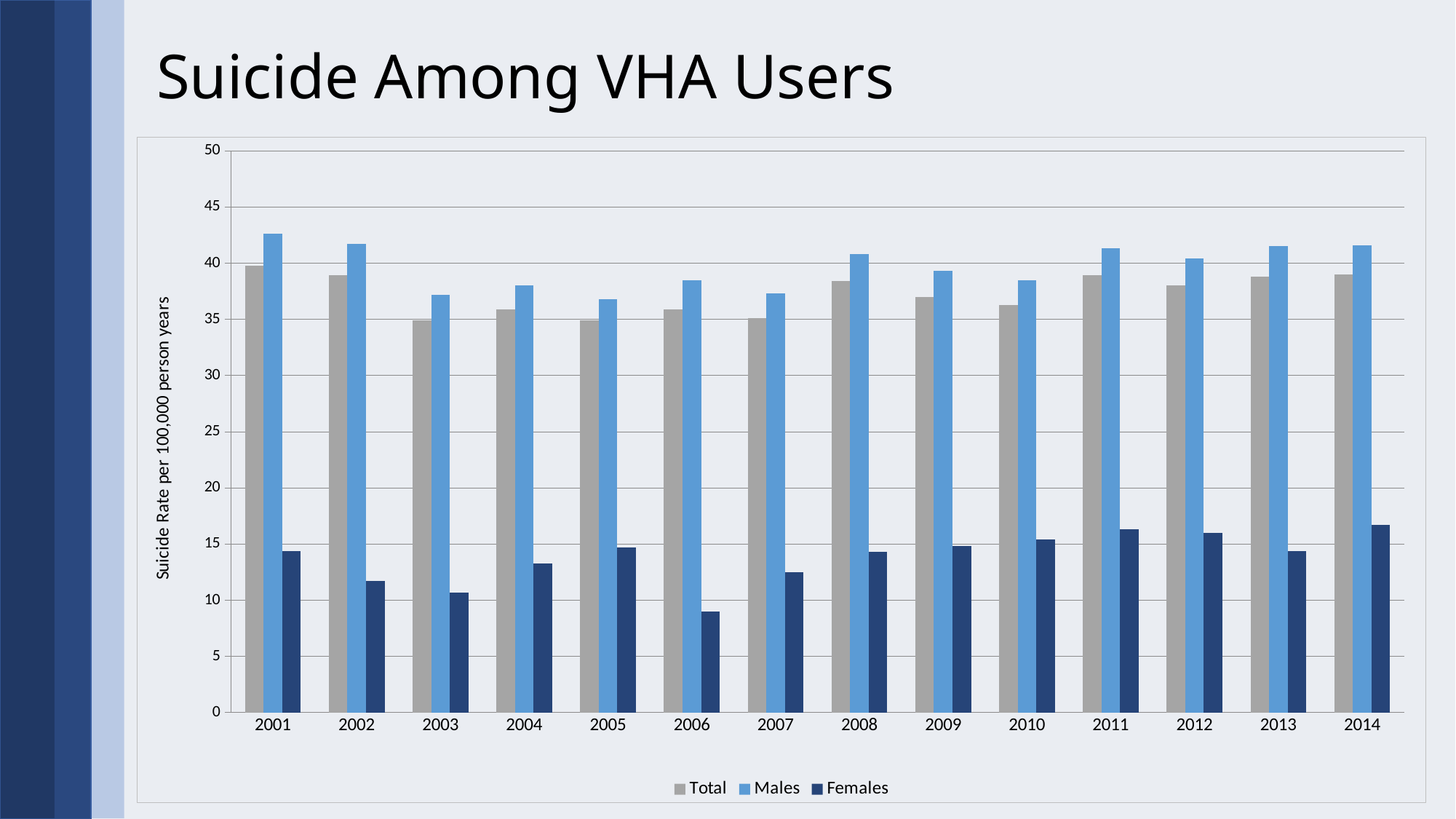
Is the value for Females in 2014 greater or less than 15? greater Which year has the highest value for Males? 2001 How many years are shown on the x axis? 14 What is the label on the vertical axis? Suicide Rate per 100,000 person years Is the value for Males in 2005 greater or less than 40? less What kind of chart is shown on the slide? bar chart Which is larger, the Females value in 2002 or the Females value in 2006? 2002 Is the value for Males in 2001 greater or less than 40? greater How many series does the legend list? 3 Do the Females values rise or fall from 2006 to 2011? rise Which year has the lowest value for Females? 2006